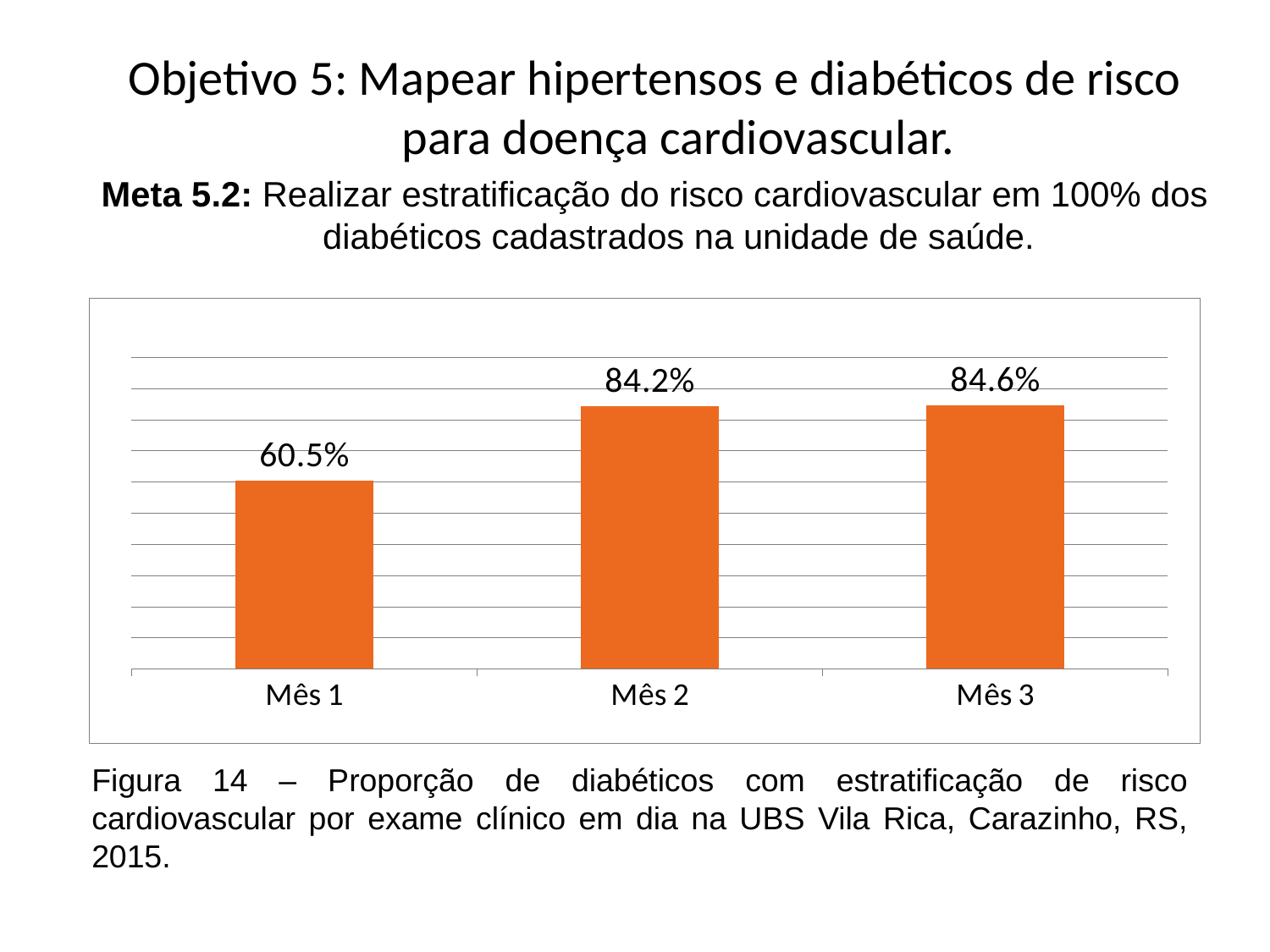
What colour are the bars in the chart? Orange What kind of chart is shown on the slide? Bar chart What is the difference between the values for Mês 3 and Mês 1? 24.1 percentage points Do the values rise or fall from Mês 1 to Mês 3? Rise Which is larger, the value for Mês 1 or the value for Mês 2? Mês 2 Which month has the lowest value? Mês 1 What is the value for Mês 2? 84.2% What is the value for Mês 1? 60.5% Which month has the highest value? Mês 3 What is the difference between the values for Mês 2 and Mês 1? 23.7 percentage points How many months are shown on the chart? 3 What is the value for Mês 3? 84.6%